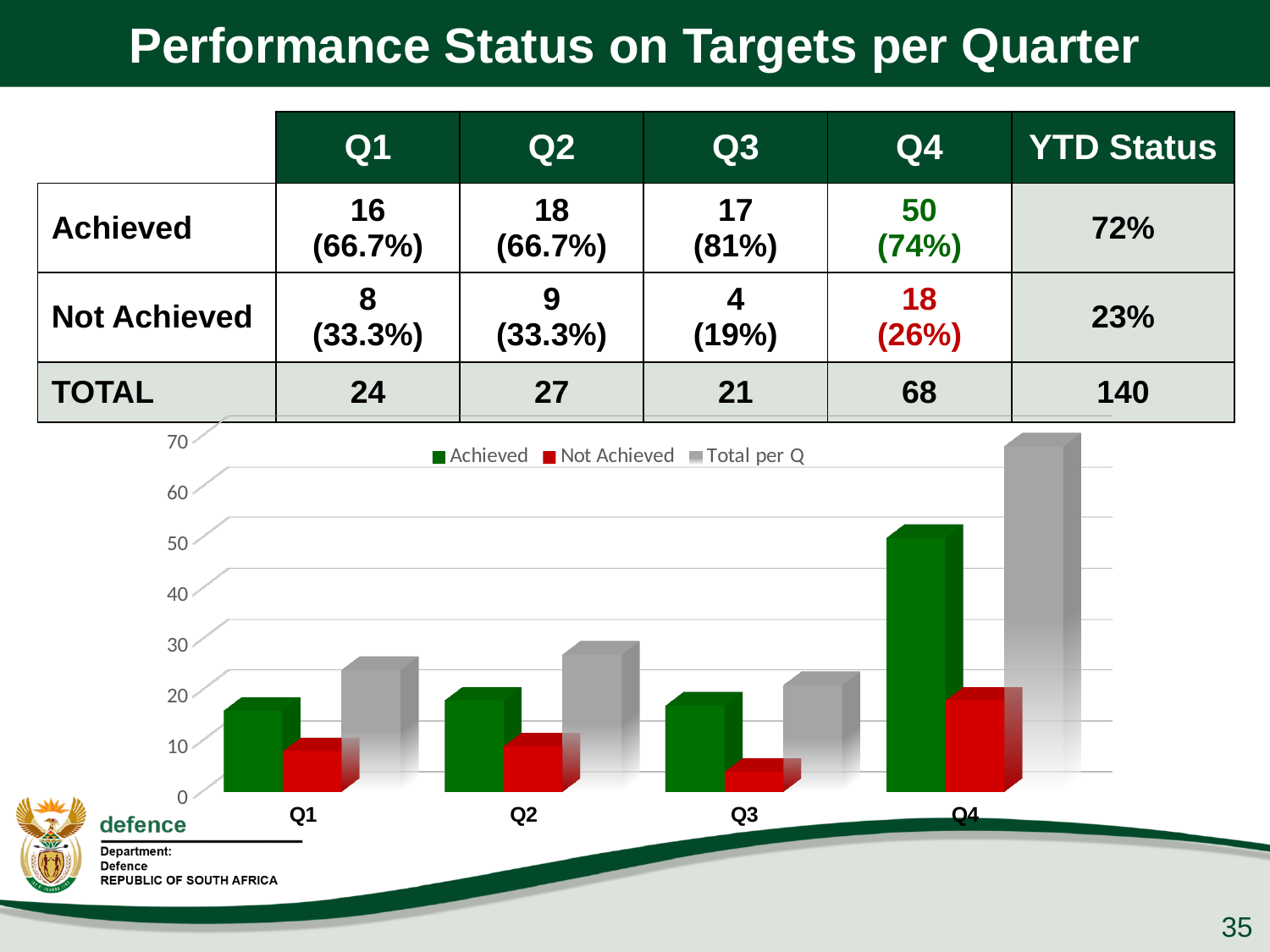
How many series does the chart legend list? 3 What is the Total per Q value for Q2? 27 How many quarters are plotted along the x axis of the chart? 4 Is the Achieved value for Q1 greater or less than 20? less What is the Achieved value for Q4? 50 What is the difference between the Achieved and Not Achieved values for Q4? 32 Is the Total per Q value for Q4 greater or less than 60? greater In the chart, is the Achieved bar larger for Q4 or for Q1? Q4 Which quarter has the lowest Not Achieved bar in the chart? Q3 What colour represents the Not Achieved series in the chart? red Which quarter has the highest Achieved bar in the chart? Q4 What kind of chart is shown on the slide? bar chart